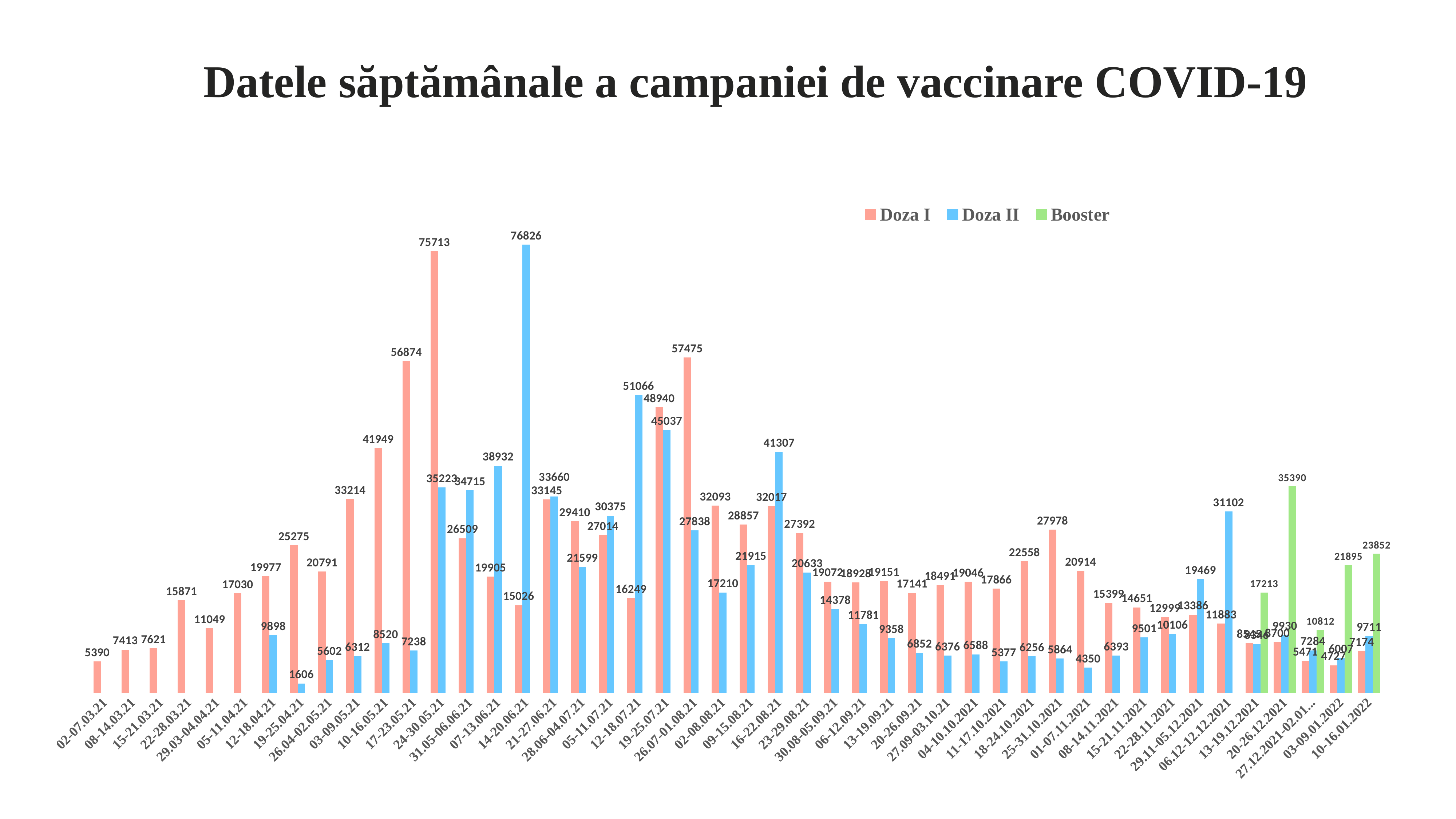
What is the Doza II value for the week 16-22.08.21? 41307 What is the Doza I value for the week 17-23.05.21? 56874 How many weeks have a Booster bar? 5 What kind of chart is shown on the slide? Bar chart In which week is the Doza II value highest? 14-20.06.21 For the week 19-25.07.21, which is larger: Doza I or Doza II? Doza I In which week is the Doza II value lowest? 19-25.04.21 What is the difference between the Booster values for 20-26.12.2021 and 13-19.12.2021? 18177 What is the Booster value for the week 10-16.01.2022? 23852 How many series does the legend list? 3 What is the difference between the Doza II and Doza I values for the week 14-20.06.21? 61800 In which week is the Doza I value highest? 24-30.05.21